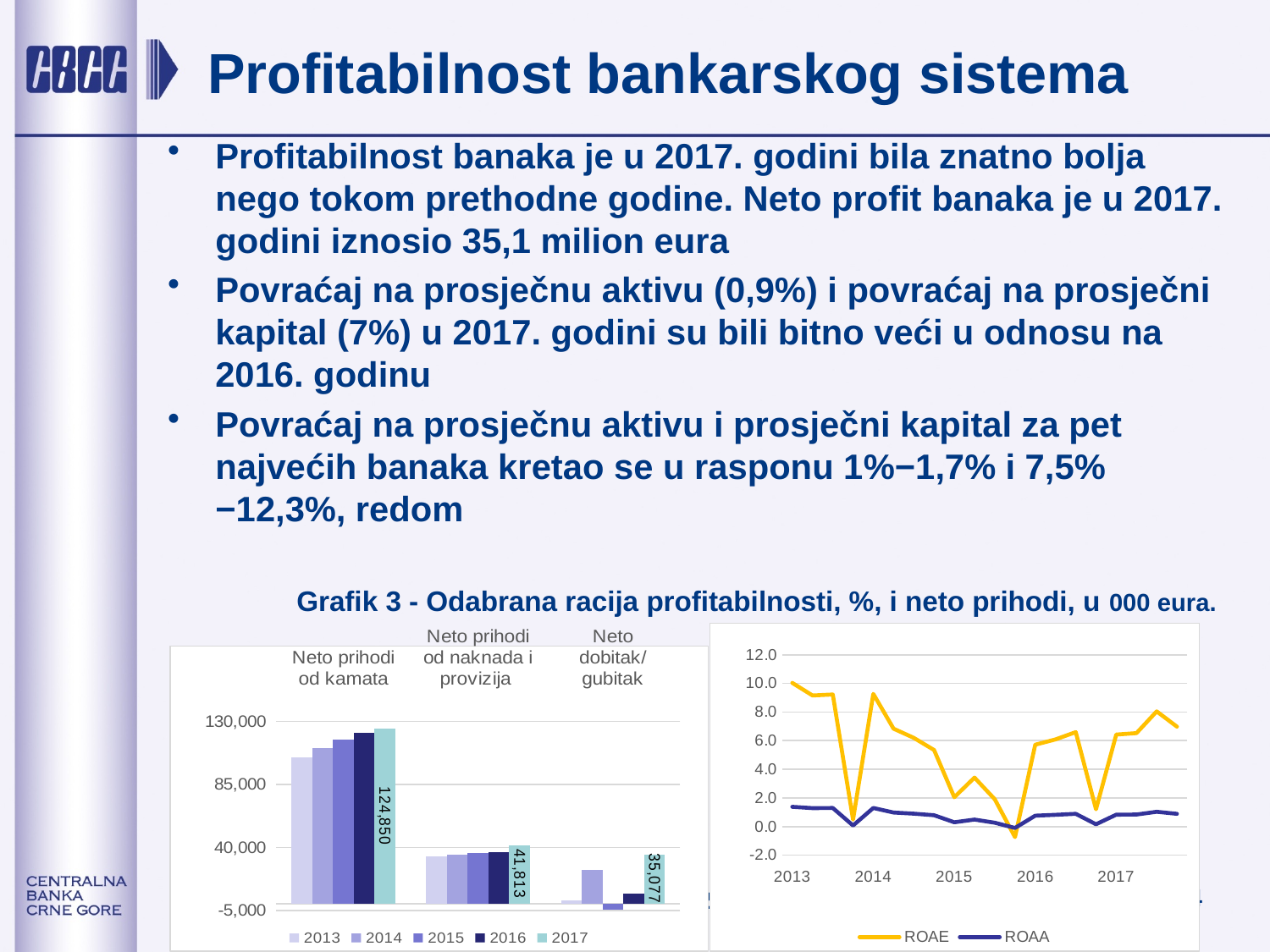
In the left bar chart, what is the value for Neto prihodi od naknada i provizija in 2017? 41,813 In the left bar chart, what is the difference between the 2017 values for Neto prihodi od kamata and Neto prihodi od naknada i provizija? 83,037 In the right line chart, how many series does the legend list? 2 In the left bar chart, how many series does the legend list? 5 In the left bar chart, what is the value for Neto prihodi od kamata in 2017? 124,850 In the left bar chart, what is the value for Neto dobitak/gubitak in 2017? 35,077 What kind of chart is the right chart on the slide? line chart In the left bar chart, how many categories are shown on the x axis? 3 What kind of chart is the left chart on the slide? bar chart In the left bar chart, is the value for Neto prihodi od kamata in 2013 greater or less than 85,000? greater In the right line chart, which series is higher at the start of 2013, ROAE or ROAA? ROAE In the left bar chart, which category has the highest value in 2017? Neto prihodi od kamata